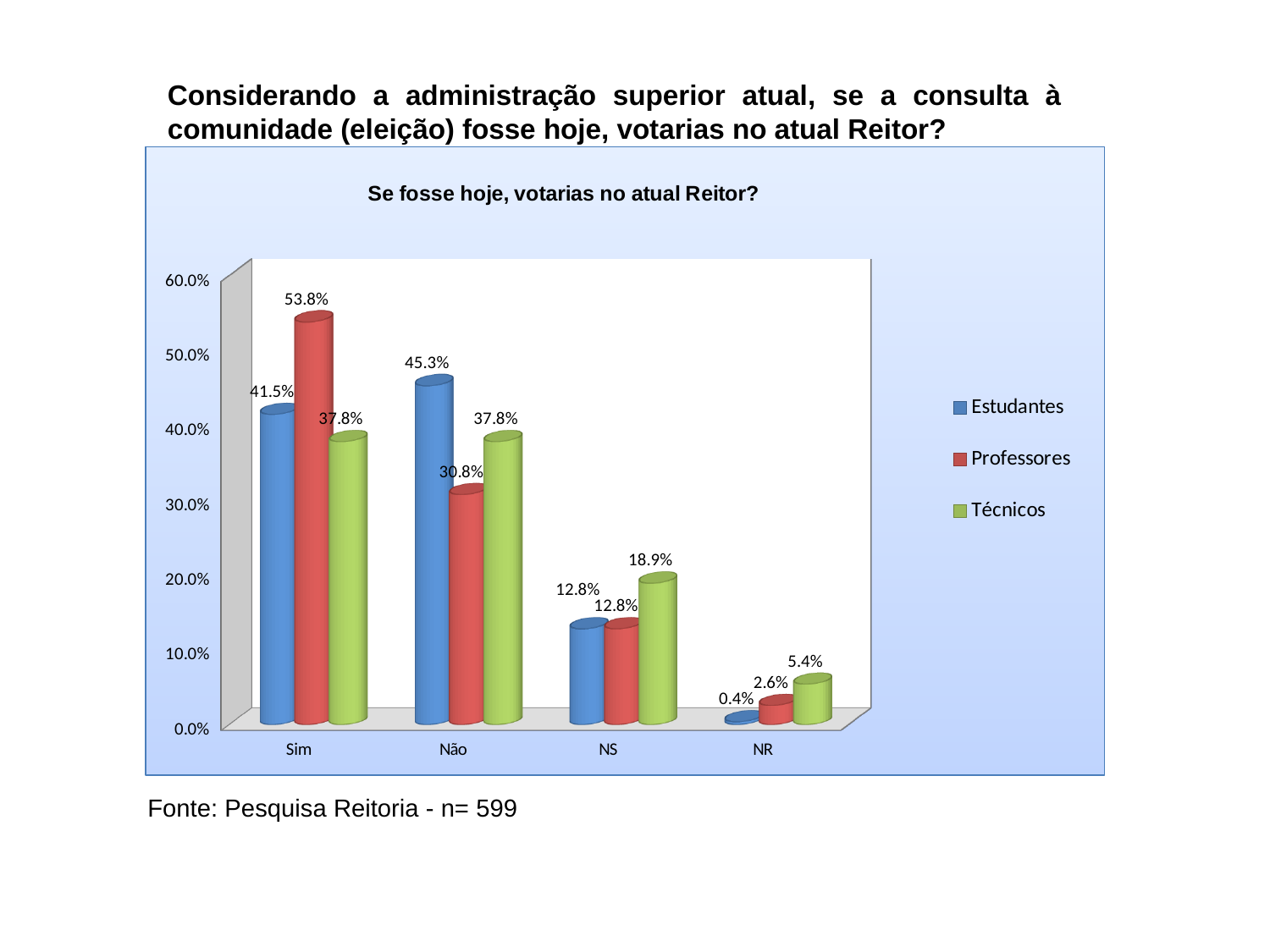
What is the value for Estudantes in the NR category? 0.4% Which category has the highest value for Professores? Sim What is the value for Técnicos in the NS category? 18.9% Which category has the lowest value for Técnicos? NR Which is larger in the Não category: Estudantes or Professores? Estudantes How many categories are shown on the x axis? 4 What is the title of the chart? Se fosse hoje, votarias no atual Reitor? What is the difference between the Professores and Estudantes values in the Sim category? 12.3% What is the value for Professores in the Sim category? 53.8% How many series does the legend list? 3 What is the value for Estudantes in the Não category? 45.3% What kind of chart is shown? Bar chart